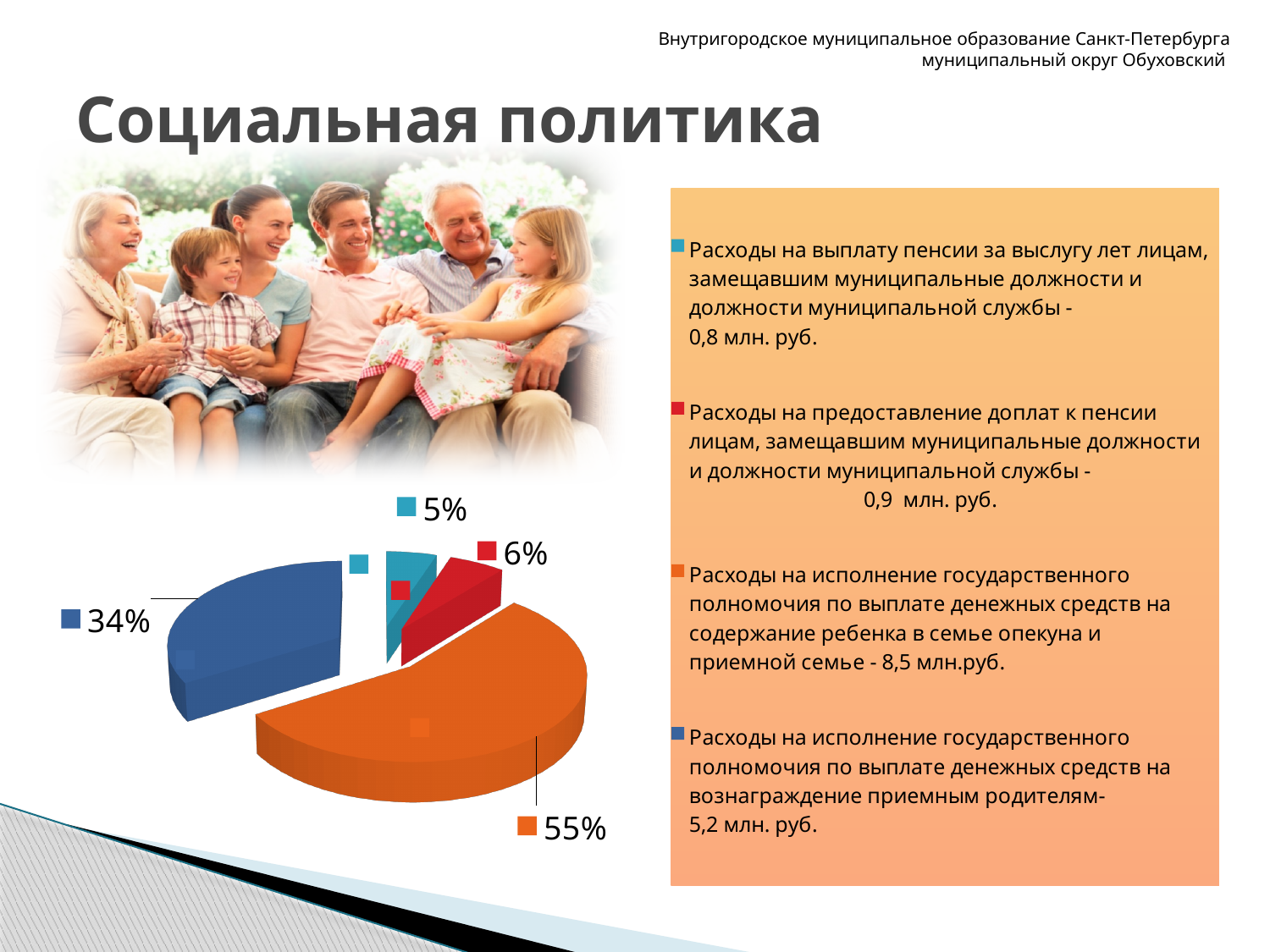
How many slices does the pie chart have? 4 Which slice of the pie chart is the largest? the orange slice (55%) According to the legend, what amount in млн. руб. corresponds to the orange slice (expenses for child maintenance in guardian and foster families)? 8,5 млн.руб. What share of the pie does the orange slice represent? 55% Which slice of the pie chart is the smallest? the teal slice (5%) What share of the pie does the blue slice represent? 34% According to the legend, what amount in млн. руб. corresponds to the blue slice (expenses for remuneration of foster parents)? 5,2 млн. руб. What share of the pie does the red slice represent? 6% What kind of chart is shown on the slide? pie chart What is the difference in percentage points between the orange slice and the blue slice? 21 Which is larger, the red slice or the teal slice? the red slice